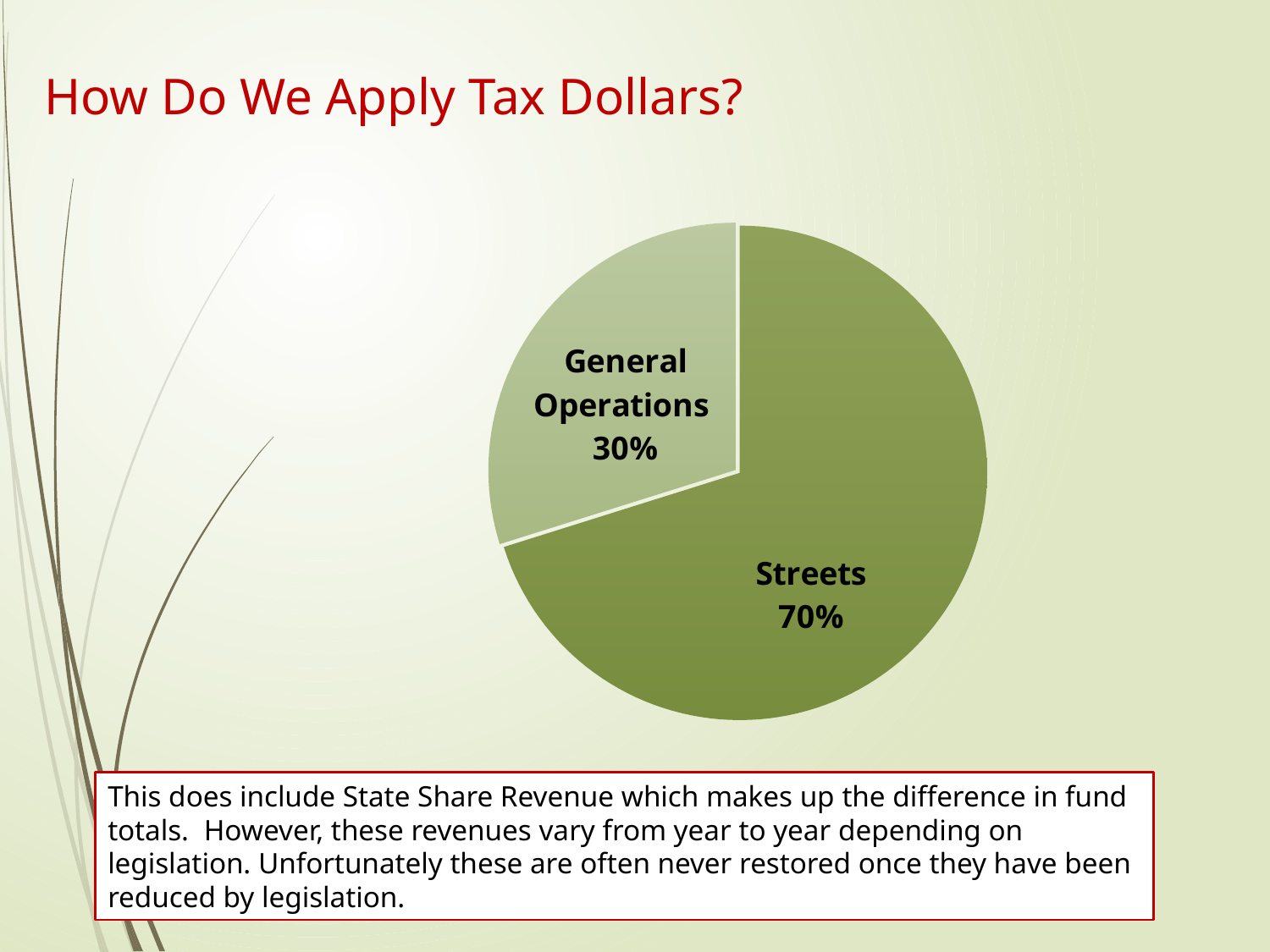
Which category receives the smallest share of tax dollars? General Operations Is the share for General Operations greater or less than 50%? less What kind of chart is shown on the slide? pie chart How many slices does the pie chart have? 2 Which slice of the pie chart is shown in the lighter green colour? General Operations What share of tax dollars goes to Streets? 70% What share of tax dollars goes to General Operations? 30% Which category receives the largest share of tax dollars? Streets What is the title of the slide containing the pie chart? How Do We Apply Tax Dollars? What is the difference in percentage points between the Streets share and the General Operations share? 40 Which is larger, the share for Streets or the share for General Operations? Streets